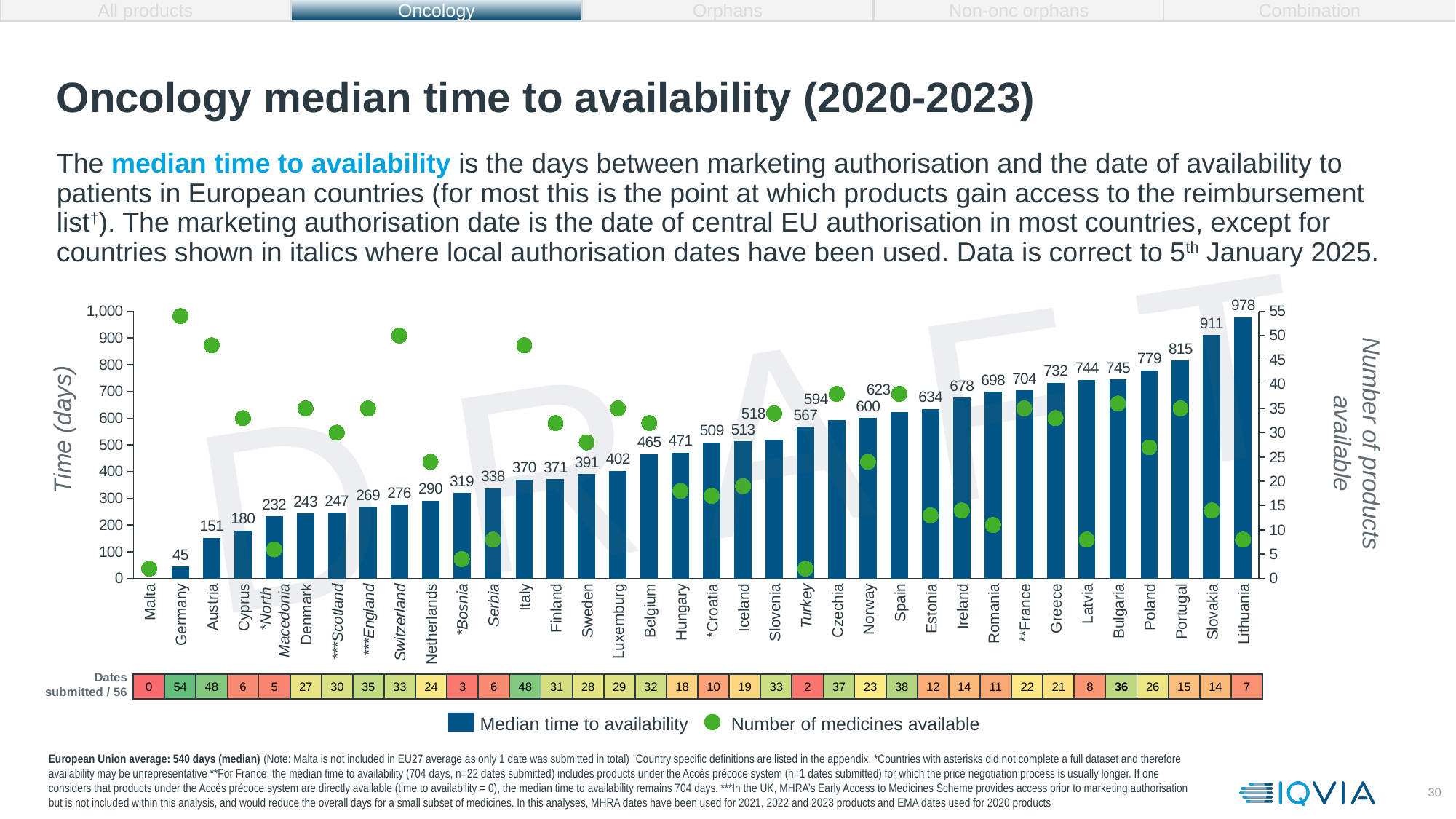
Which has a larger median time to availability, Poland or Portugal? Portugal What is the median time to availability for Lithuania? 978 Which country has the highest median time to availability? Lithuania How many series does the chart legend list? 2 How many countries are shown on the x axis of the chart? 36 What is the median time to availability for Spain? 623 What kind of chart is used to show the median time to availability? bar chart Do the median time to availability values rise or fall from left to right along the x axis? rise Is the number of medicines available for Germany greater or less than 50? greater What is the difference in median time to availability between Lithuania and Slovakia? 67 What is the median time to availability for Germany? 45 What is the difference in median time to availability between Austria and Germany? 106